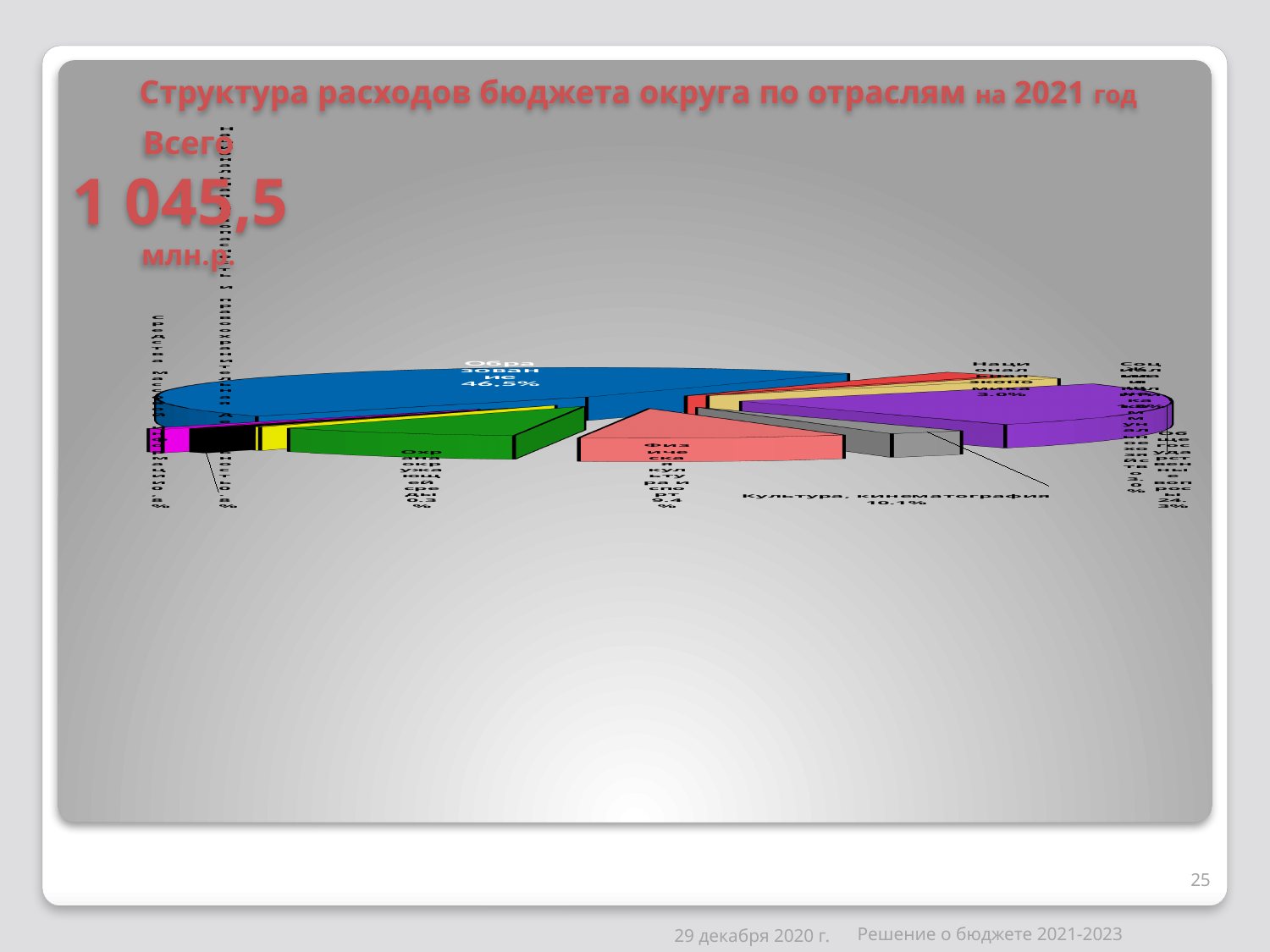
What share is shown for Культура, кинематография? 10.1% Which is larger: the share for Национальная экономика or for Охрана окружающей среды? Национальная экономика What is the title of the chart? Структура расходов бюджета округа по отраслям на 2021 год What share is shown for Национальная экономика? 3.0% What is the total budget expenditure stated on the slide? 1 045,5 млн.р. What share is shown for Охрана окружающей среды? 0.3% What share of the budget expenditure goes to Образование? 46.5% Which is larger: the share for Культура, кинематография or for Физическая культура и спорт? Культура, кинематография By how many percentage points does the share for Образование exceed the share for Культура, кинематография? 36.4 percentage points Which sector has the largest share of the budget expenditure? Образование What share is shown for Физическая культура и спорт? 9.4% What kind of chart is shown on the slide? Pie chart